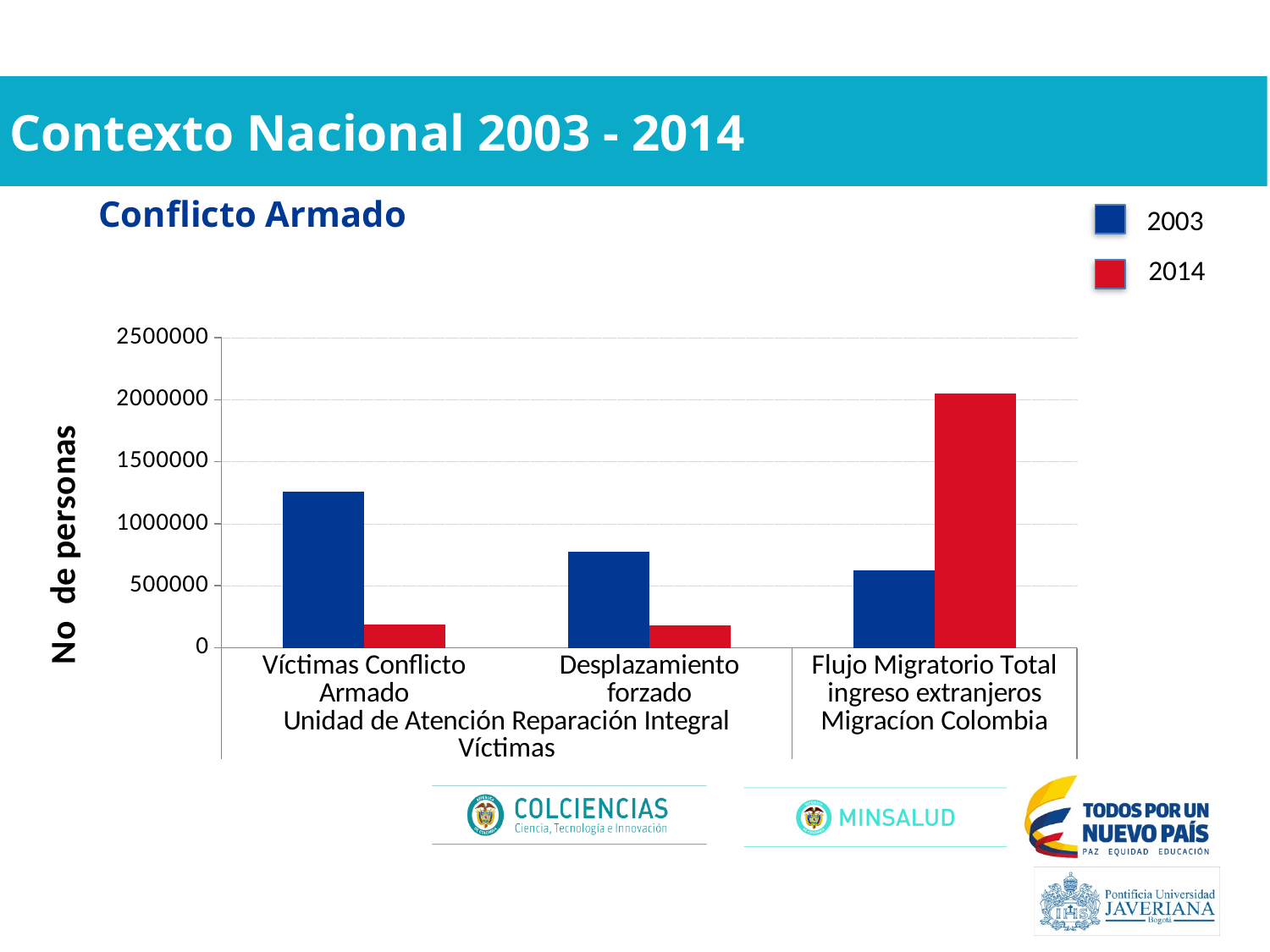
Is the 2014 value for Flujo Migratorio Total ingreso extranjeros greater or less than 2000000? greater Which category has the lowest 2003 value? Flujo Migratorio Total ingreso extranjeros For Víctimas Conflicto Armado, which is larger, the 2003 value or the 2014 value? 2003 Which colour represents the 2014 series in the legend? red Is the 2003 value for Desplazamiento forzado greater or less than 1000000? less How many categories are shown on the x axis? 3 For Flujo Migratorio Total ingreso extranjeros, which is larger, the 2003 value or the 2014 value? 2014 Which category has the highest 2014 value? Flujo Migratorio Total ingreso extranjeros How many series does the legend list? 2 What kind of chart is shown on the slide? bar chart What is the label on the y axis? No de personas Which category has the highest 2003 value? Víctimas Conflicto Armado